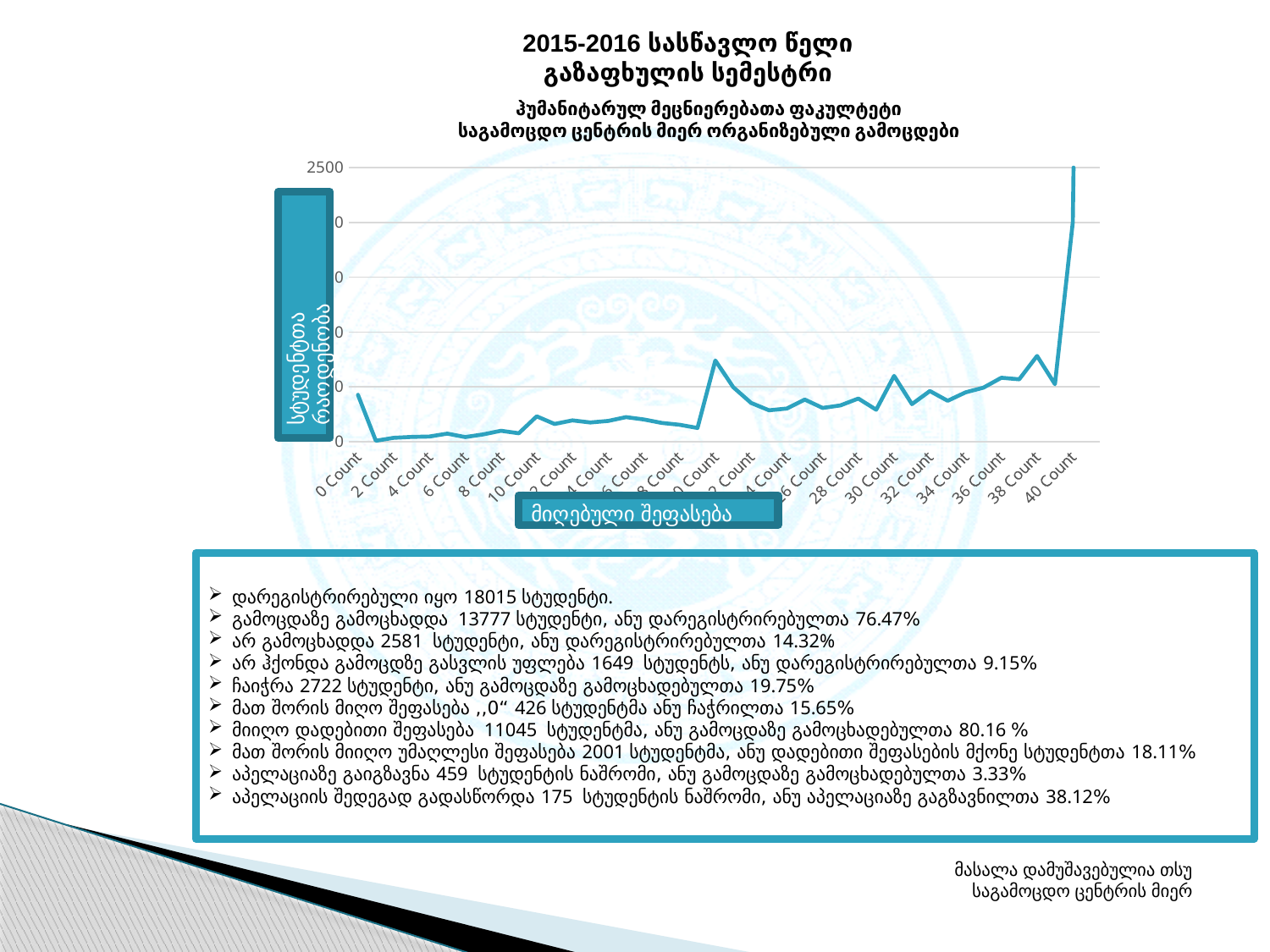
Which is larger, the value for 0 Count or the value for 1 Count? 0 Count Which is larger, the value for 20 Count or the value for 10 Count? 20 Count Does the line rise or fall between 38 Count and 40 Count? rise Which is larger, the value for 40 Count or the value for 0 Count? 40 Count What is the label of the x axis of the chart? მიღებული შეფასება What is the highest value labelled on the y axis? 2500 What is the first category label on the x axis? 0 Count What is the last category label on the x axis? 40 Count What kind of chart is shown on the slide? line chart